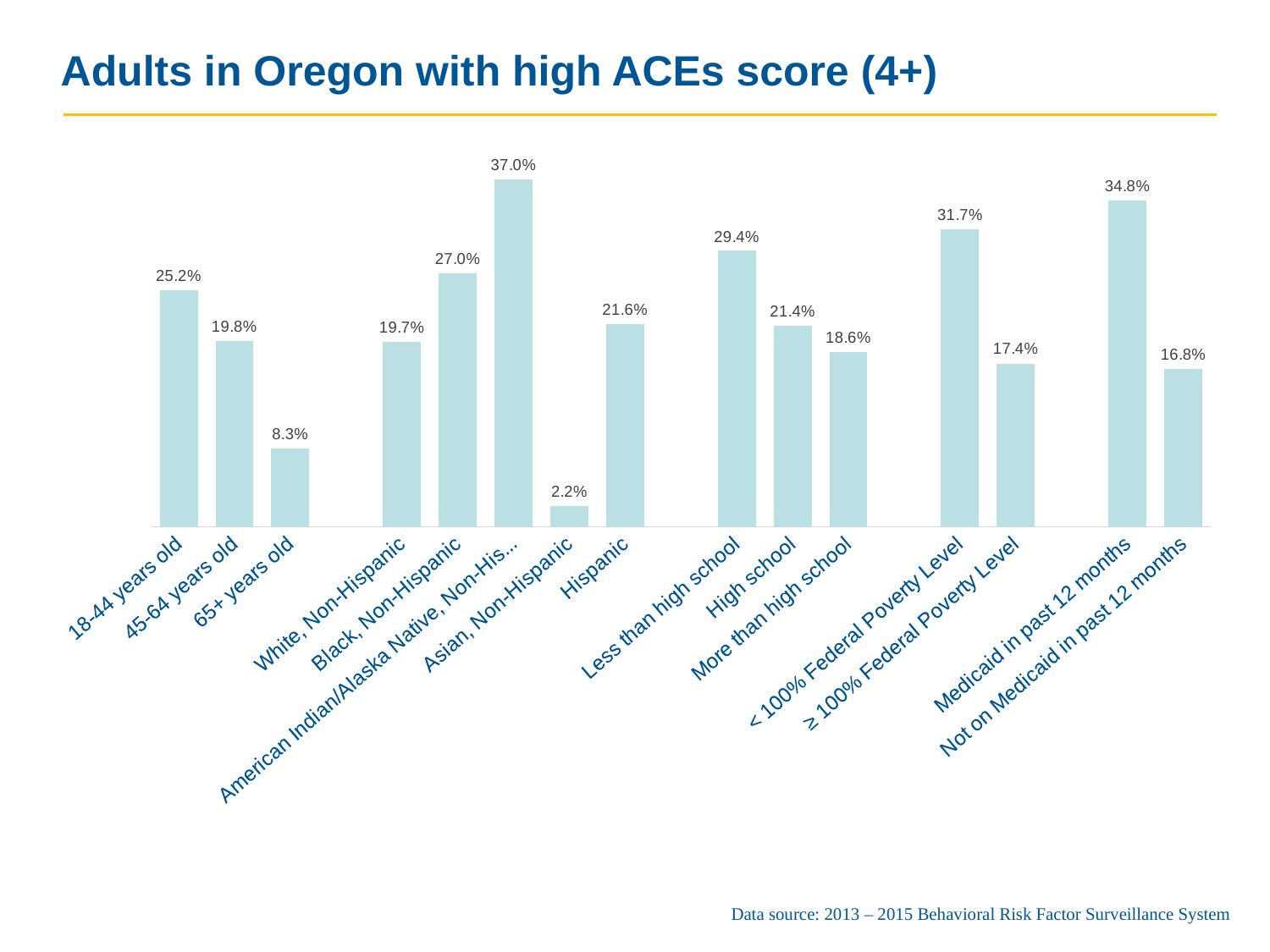
What is the value for Less than high school? 29.4% What is the title of the chart? Adults in Oregon with high ACEs score (4+) Which category has the highest value? American Indian/Alaska Native, Non-Hispanic How many categories are shown in the chart? 14 What is the difference between the values for 18-44 years old and 65+ years old? 16.9% What is the value for 18-44 years old? 25.2% Which is larger, the value for Black, Non-Hispanic or the value for White, Non-Hispanic? Black, Non-Hispanic What is the difference between the values for Medicaid in past 12 months and Not on Medicaid in past 12 months? 18.0% What is the value for Hispanic? 21.6% Which category has the lowest value? Asian, Non-Hispanic What is the value for Medicaid in past 12 months? 34.8% What kind of chart is shown on the slide? Bar chart